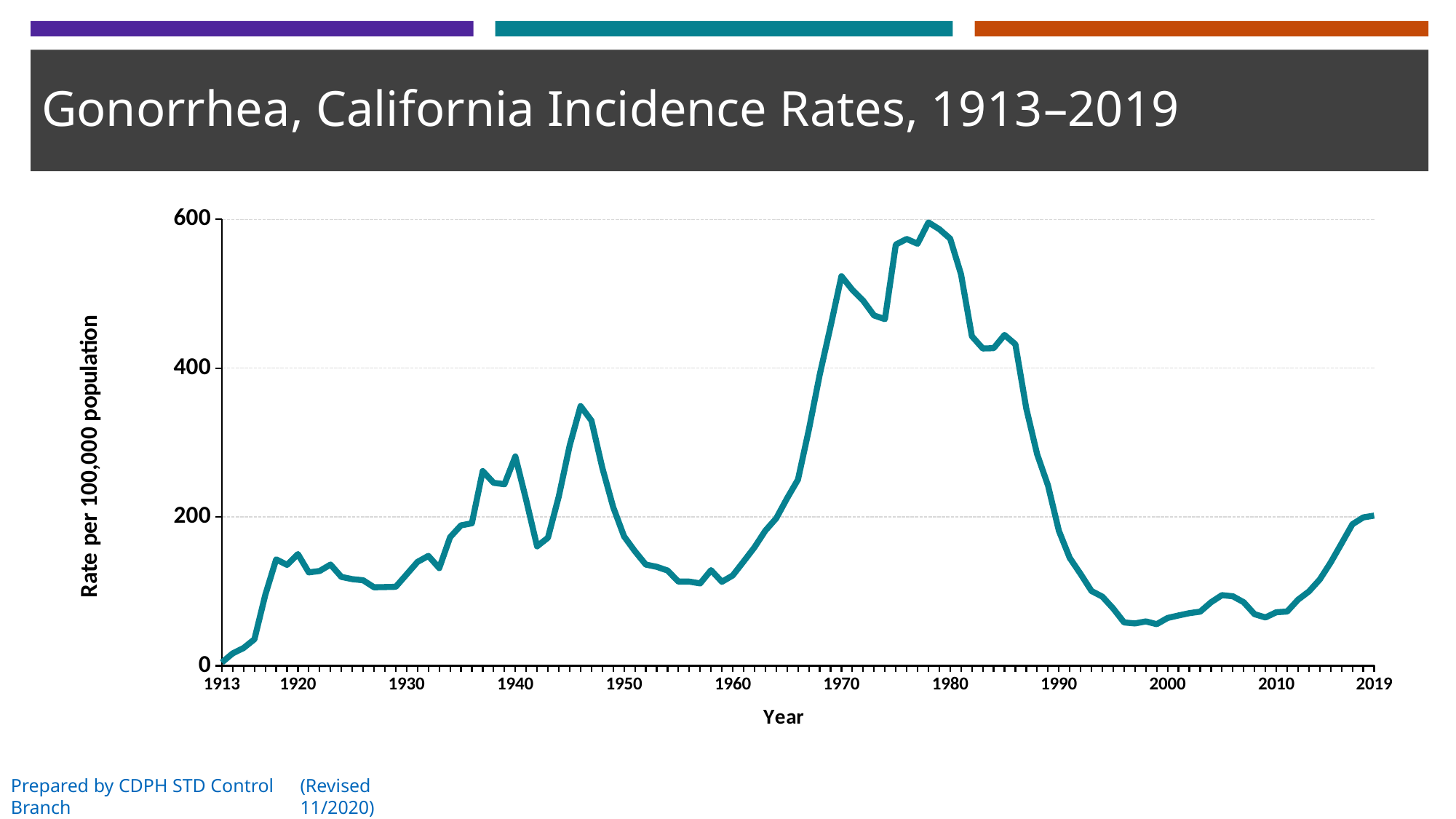
Is the value for 1946 greater or less than 200? greater What kind of chart is shown on the slide? line chart In which decade does the line reach its highest point? 1970s Which year has the lowest value on the chart? 1913 Does the line rise or fall between 2010 and 2019? rise What is the label on the y axis? Rate per 100,000 population Is the value for 2000 greater or less than 100? less What is the title of the chart? Gonorrhea, California Incidence Rates, 1913–2019 Is the value for 1930 greater or less than 200? less